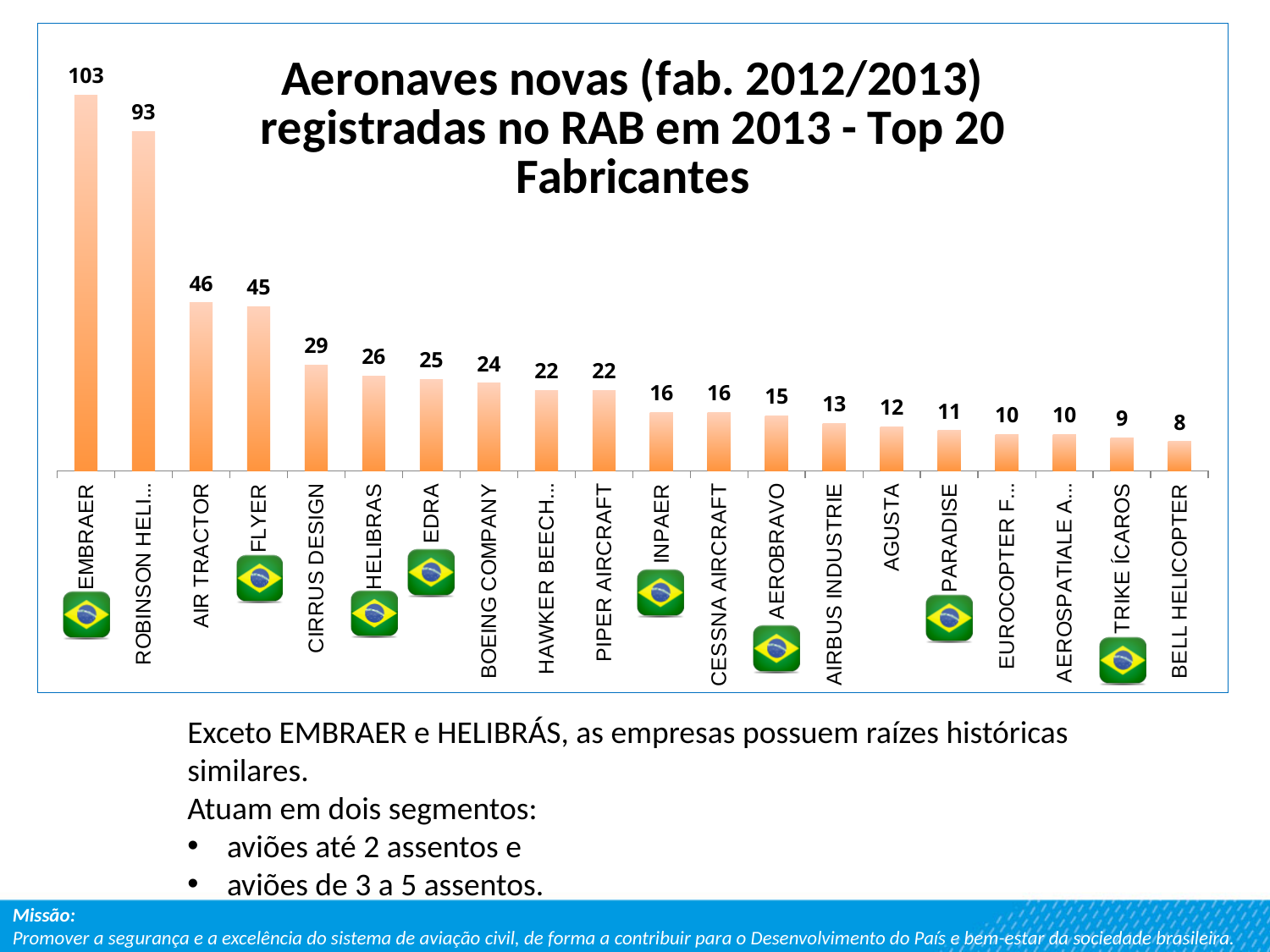
Which manufacturer has the lowest value? BELL HELICOPTER What is the value for AGUSTA? 12 What is the value for CIRRUS DESIGN? 29 What is the difference between the values for EMBRAER and AIR TRACTOR? 57 What is the value for EMBRAER? 103 What is the title of the chart? Aeronaves novas (fab. 2012/2013) registradas no RAB em 2013 - Top 20 Fabricantes What kind of chart is shown on the slide? Bar chart Do the values rise or fall from left to right along the x axis? Fall Which is larger, the value for HELIBRAS or the value for EDRA? HELIBRAS What is the value for AIR TRACTOR? 46 How many manufacturers are shown in the chart? 20 Which manufacturer has the highest value? EMBRAER